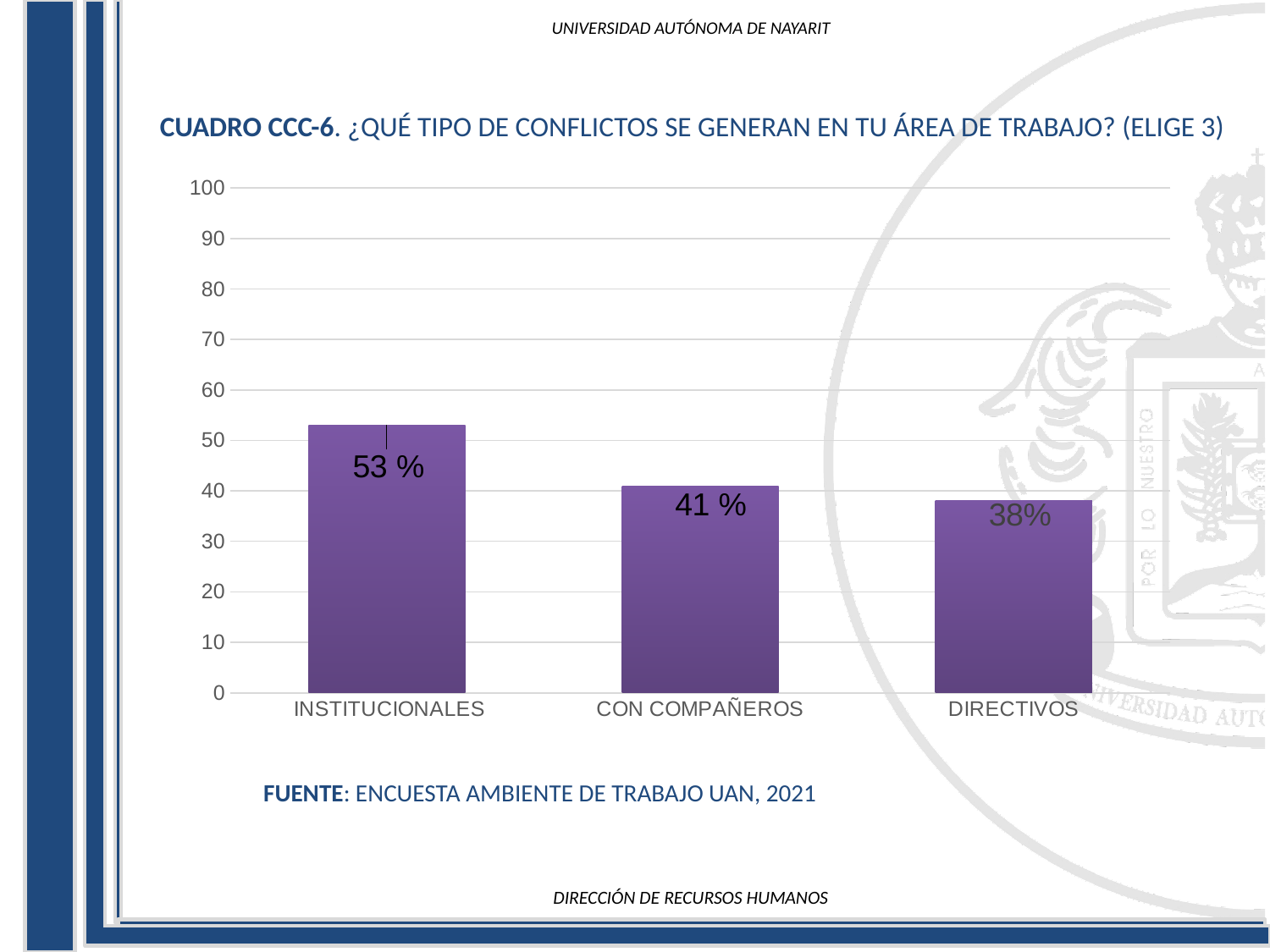
Which category has the lowest value? DIRECTIVOS What is the value for INSTITUCIONALES? 53 % What is the difference between the values for INSTITUCIONALES and CON COMPAÑEROS? 12 What is the value for CON COMPAÑEROS? 41 % Which is larger, the value for CON COMPAÑEROS or the value for DIRECTIVOS? CON COMPAÑEROS Do the values rise or fall from left to right along the x axis? fall Which category has the highest value? INSTITUCIONALES How many categories are shown on the x axis? 3 What kind of chart is shown on the slide? bar chart What is the value for DIRECTIVOS? 38% What is the difference between the values for INSTITUCIONALES and DIRECTIVOS? 15 Is the value for INSTITUCIONALES greater or less than 50? greater